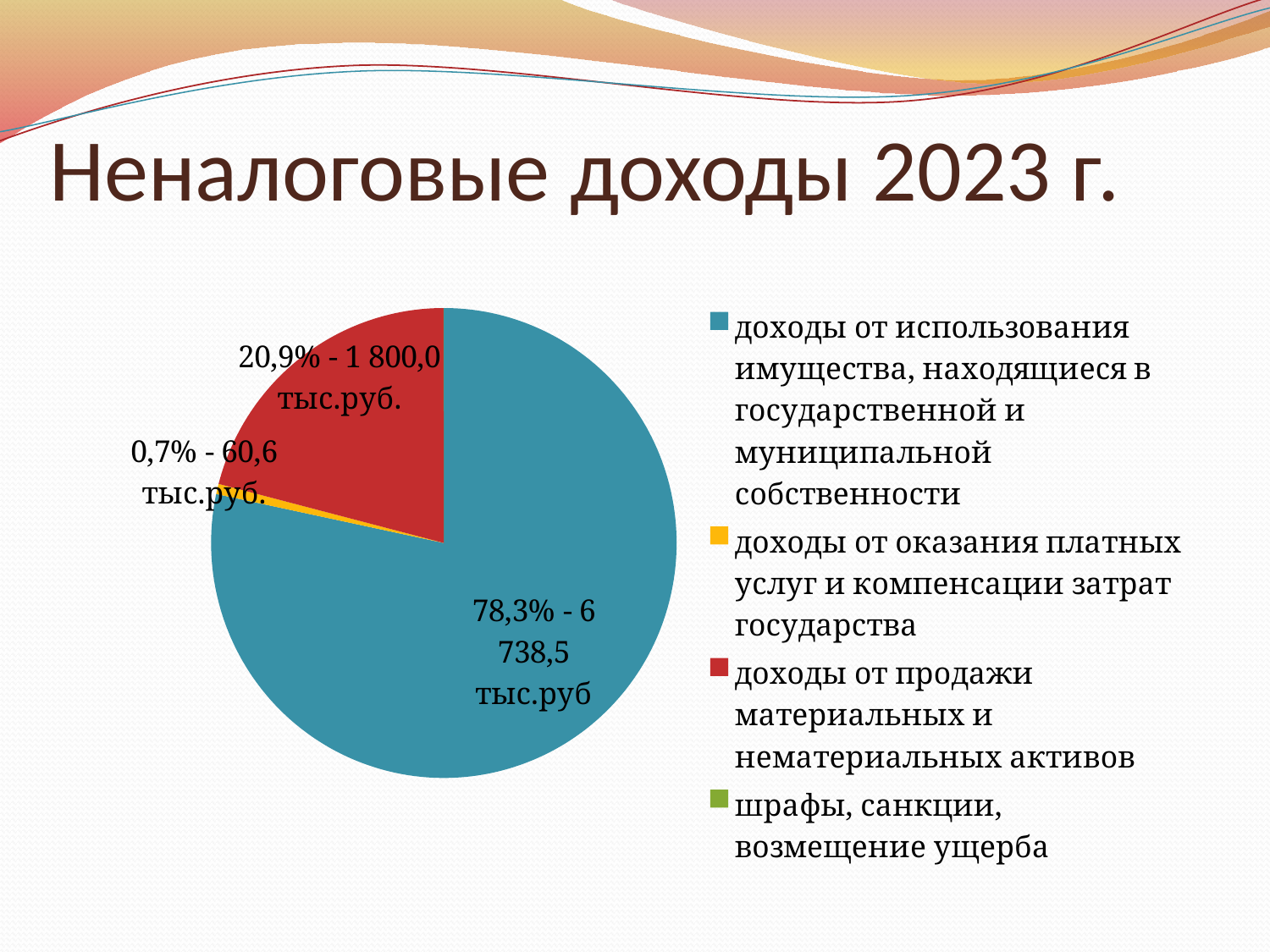
What share of the pie is taken by доходы от использования имущества, находящиеся в государственной и муниципальной собственности? 78,3% What share of the pie is taken by доходы от оказания платных услуг и компенсации затрат государства? 0,7% Which category has the largest slice of the pie? доходы от использования имущества, находящиеся в государственной и муниципальной собственности How many entries does the chart legend list? 4 Which is larger: the share for доходы от продажи материальных и нематериальных активов or the share for доходы от оказания платных услуг и компенсации затрат государства? доходы от продажи материальных и нематериальных активов What colour is the slice for доходы от продажи материальных и нематериальных активов? red What is the title of the chart on the slide? Неналоговые доходы 2023 г. What is the value in тыс.руб. for доходы от оказания платных услуг и компенсации затрат государства? 60,6 тыс.руб. What is the value in тыс.руб. for доходы от продажи материальных и нематериальных активов? 1 800,0 тыс.руб. What kind of chart is shown on the slide? pie chart What share of the pie is taken by доходы от продажи материальных и нематериальных активов? 20,9% What is the value in тыс.руб. for доходы от использования имущества, находящиеся в государственной и муниципальной собственности? 6 738,5 тыс.руб